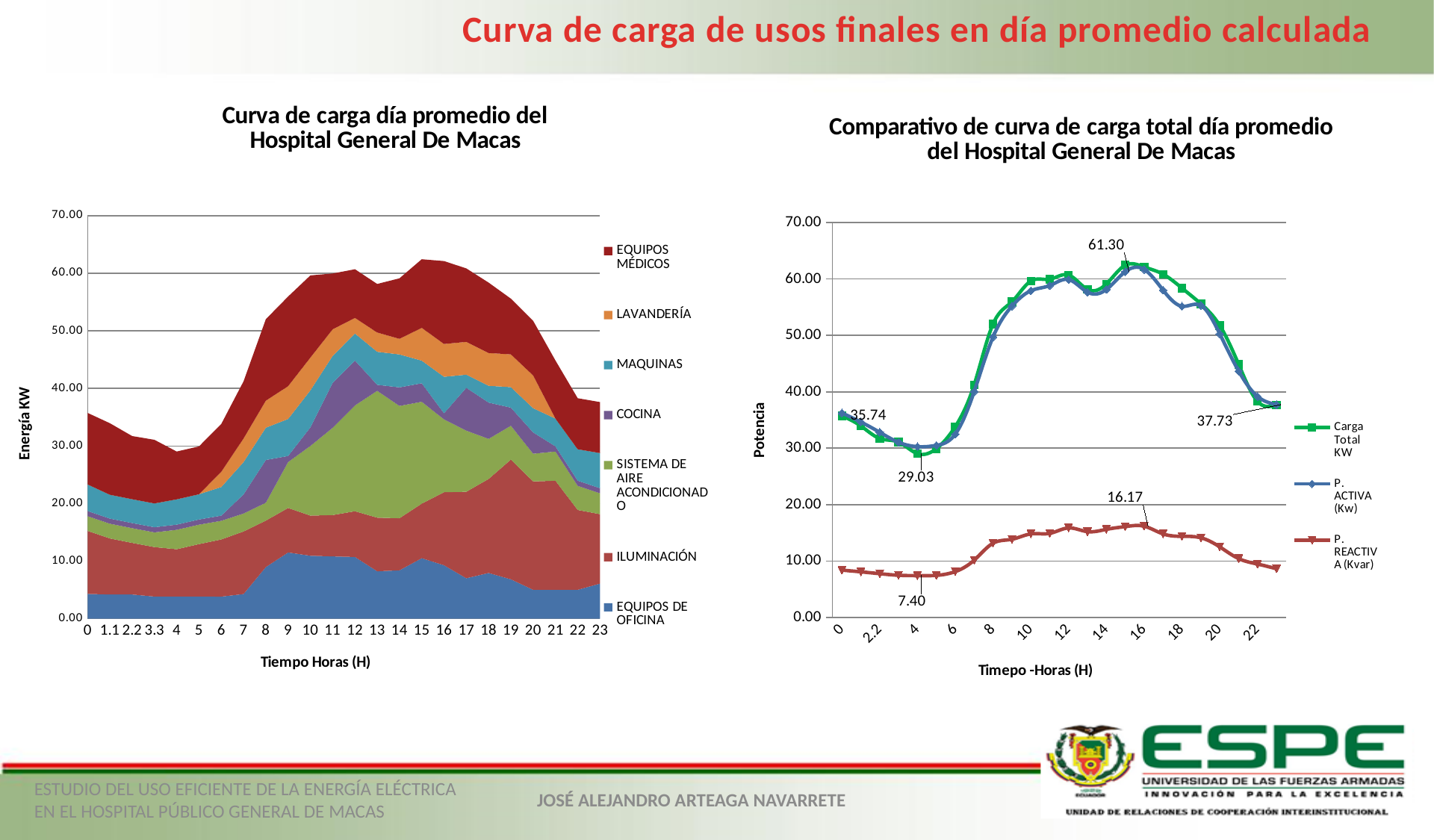
On the right chart (Comparativo de curva de carga total), how many series does the legend list? 3 On the right chart (Comparativo de curva de carga total), what value is labelled at the lowest point of the upper curves around hour 4? 29.03 On the left chart (Curva de carga día promedio), what is the title of the vertical axis? Energía KW On the right chart (Comparativo de curva de carga total), does the P. REACTIVA (Kvar) line rise or fall from hour 16 to hour 23? Fall On the left chart (Curva de carga día promedio), how many series does the legend list? 7 On the right chart (Comparativo de curva de carga total), what is the lowest labelled value on the P. REACTIVA (Kvar) line? 7.40 What kind of chart is the right chart (Comparativo de curva de carga total)? Line chart On the right chart (Comparativo de curva de carga total), what is the difference between the labelled peak 61.30 and the labelled low 29.03 of the upper curves? 32.27 On the right chart (Comparativo de curva de carga total), what is the difference between the labelled peak and the labelled low of the P. REACTIVA (Kvar) line? 8.77 On the right chart (Comparativo de curva de carga total), what value is labelled at the peak of the P. REACTIVA (Kvar) line? 16.17 On the right chart (Comparativo de curva de carga total), what value is labelled at the peak of the upper curves around hour 16? 61.30 On the right chart (Comparativo de curva de carga total), is the P. REACTIVA (Kvar) value at hour 12 greater or less than 20.00? less